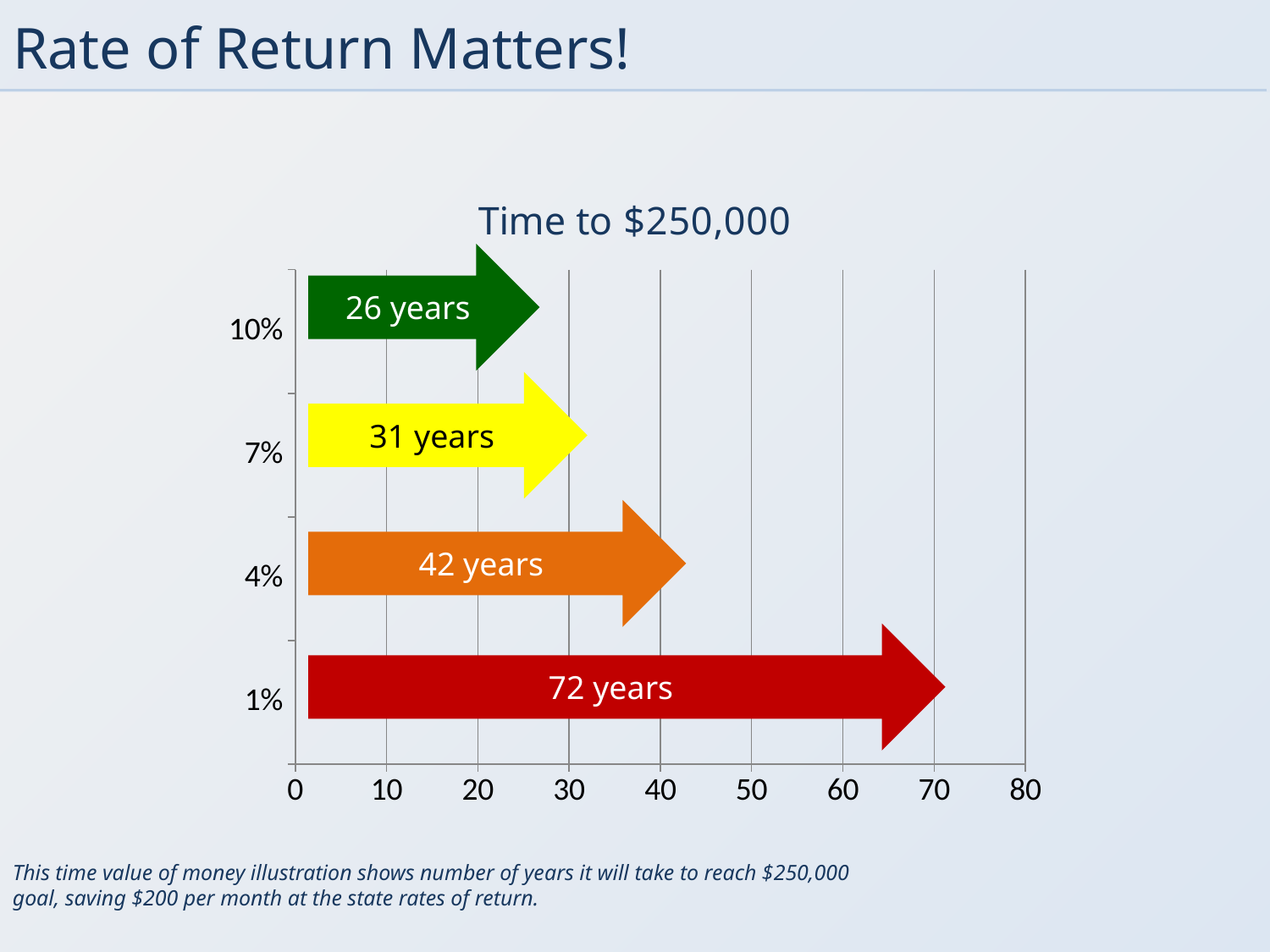
How many years does it take to reach $250,000 at a 1% rate of return? 72 years What type of chart is shown on the slide? Bar chart What is the title of the chart? Time to $250,000 How many years does it take to reach $250,000 at a 10% rate of return? 26 years How many years does it take to reach $250,000 at a 7% rate of return? 31 years Which rate of return takes the shortest time to reach $250,000? 10% Which rate of return takes the longest time to reach $250,000? 1% Which takes longer to reach $250,000: a 4% or a 7% rate of return? 4% What is the difference in years between the 4% and 7% rates of return? 11 years How many rates of return are shown in the chart? 4 How many more years does it take to reach $250,000 at 1% than at 10%? 46 years How many years does it take to reach $250,000 at a 4% rate of return? 42 years